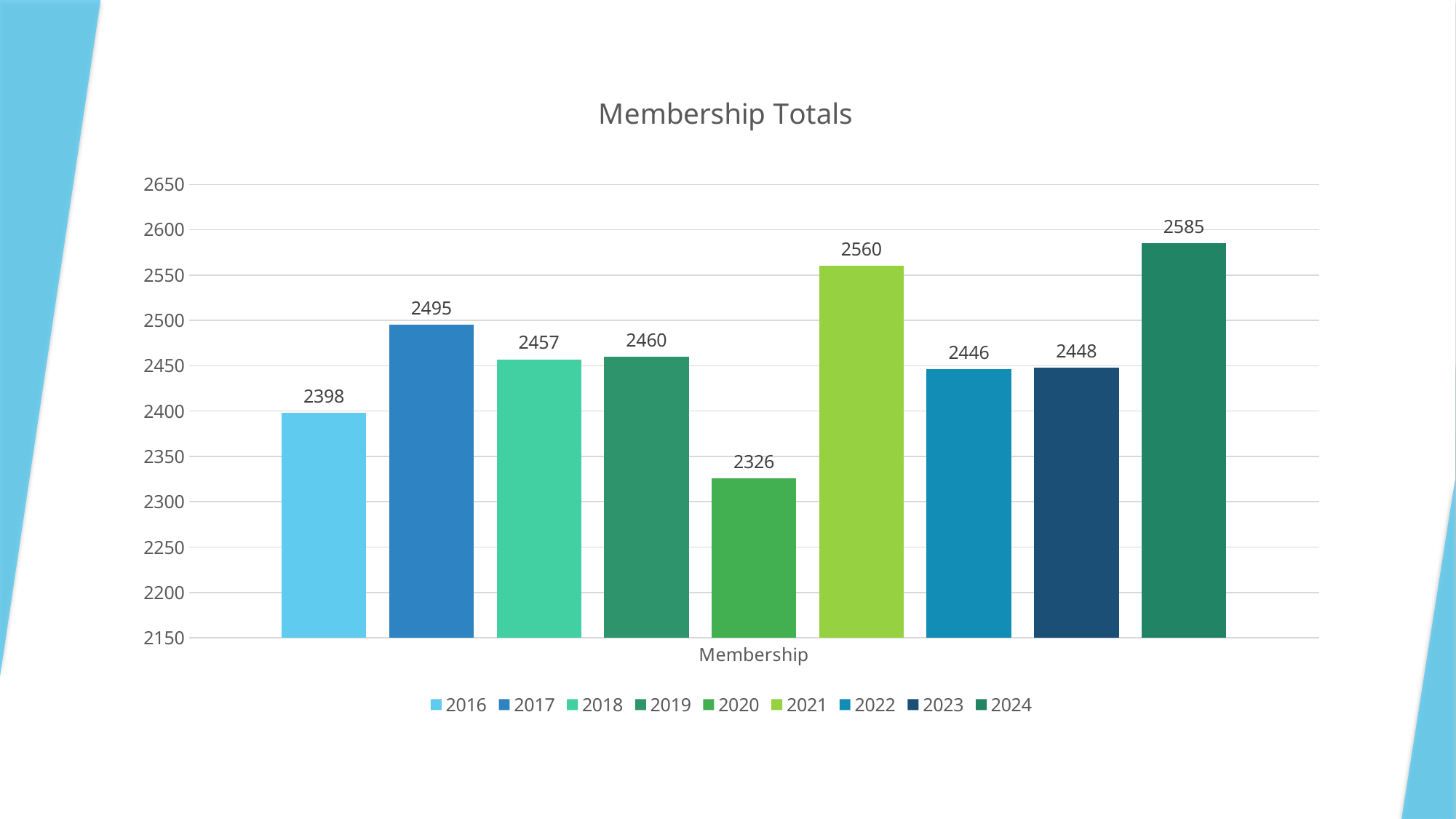
Which year has the lowest membership total? 2020 Which year has the highest membership total? 2024 What is the membership total for 2021? 2560 What is the difference between the membership totals for 2021 and 2020? 234 What kind of chart is shown on the slide? bar chart Which is larger, the membership total for 2017 or for 2018? 2017 What is the title of the chart? Membership Totals What is the membership total for 2020? 2326 What is the membership total for 2016? 2398 How many series does the legend list? 9 What is the difference between the membership totals for 2024 and 2016? 187 Is the membership total for 2022 greater or less than 2500? less